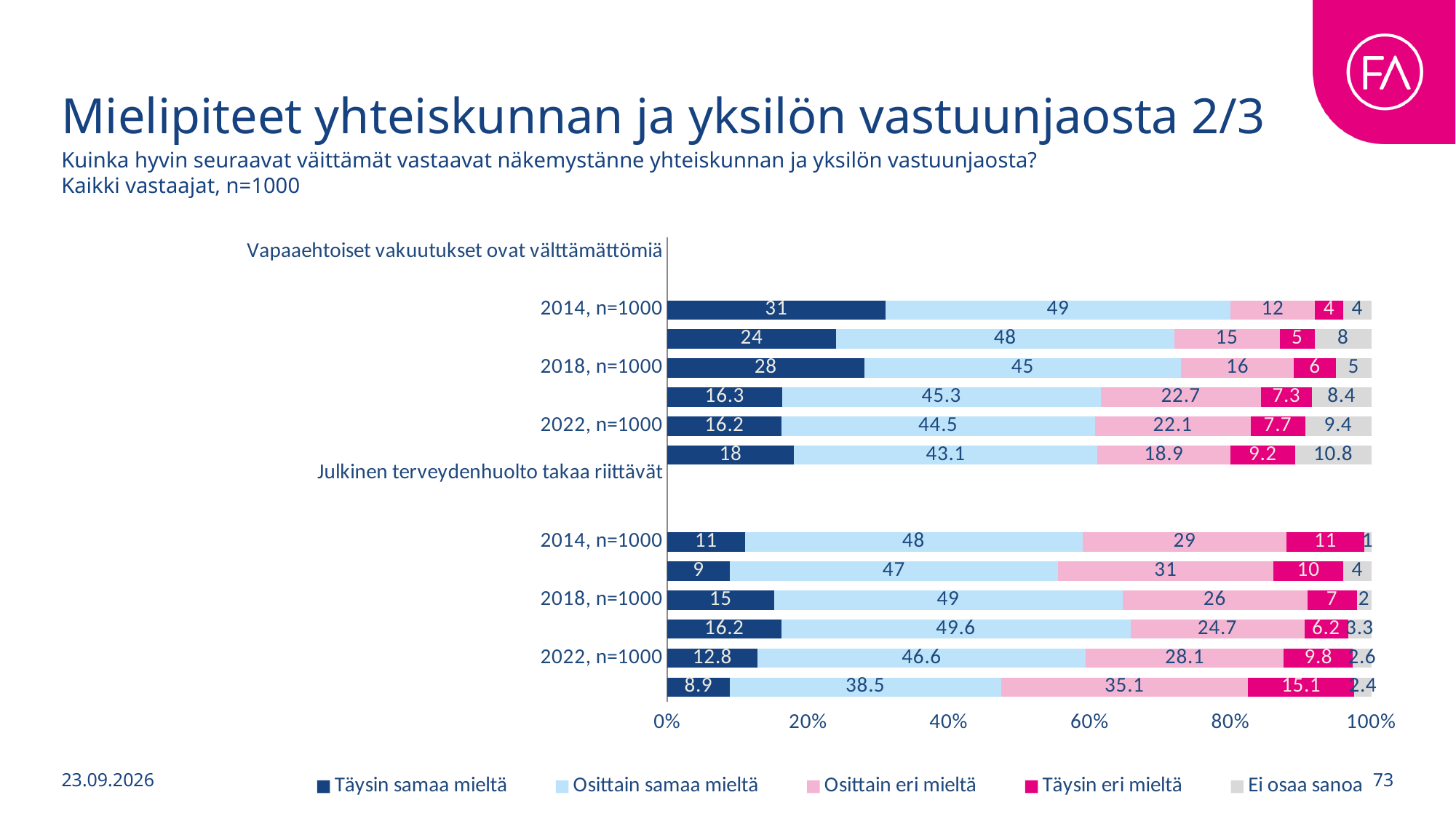
In the 'Julkinen terveydenhuolto takaa riittävät' group, what is the total of the bar labelled '2018, n=1000'? 99 In the 'Vapaaehtoiset vakuutukset ovat välttämättömiä' group, what is the 'Ei osaa sanoa' value for the bar labelled '2022, n=1000'? 9.4 In the 'Vapaaehtoiset vakuutukset ovat välttämättömiä' group, what is the difference between the 'Täysin samaa mieltä' values for the bars labelled '2014, n=1000' and '2018, n=1000'? 3 In the 'Julkinen terveydenhuolto takaa riittävät' group, what is the 'Täysin eri mieltä' value for the bar labelled '2022, n=1000'? 9.8 In the 'Vapaaehtoiset vakuutukset ovat välttämättömiä' group, what is the 'Täysin samaa mieltä' value for the bar labelled '2014, n=1000'? 31 In the 'Vapaaehtoiset vakuutukset ovat välttämättömiä' group, what is the 'Osittain samaa mieltä' value for the bar labelled '2018, n=1000'? 45 In the 'Julkinen terveydenhuolto takaa riittävät' group, which is larger: the 'Täysin samaa mieltä' value for the bar labelled '2018, n=1000' or for the bar labelled '2014, n=1000'? 2018, n=1000 In the 'Julkinen terveydenhuolto takaa riittävät' group, what is the 'Osittain eri mieltä' value for the bar labelled '2014, n=1000'? 29 What kind of chart is shown on the slide? Stacked bar chart In the 'Vapaaehtoiset vakuutukset ovat välttämättömiä' group, what is the difference between the 'Osittain eri mieltä' values for the bars labelled '2022, n=1000' and '2014, n=1000'? 10.1 How many series does the legend list? 5 What is the title of the slide? Mielipiteet yhteiskunnan ja yksilön vastuunjaosta 2/3